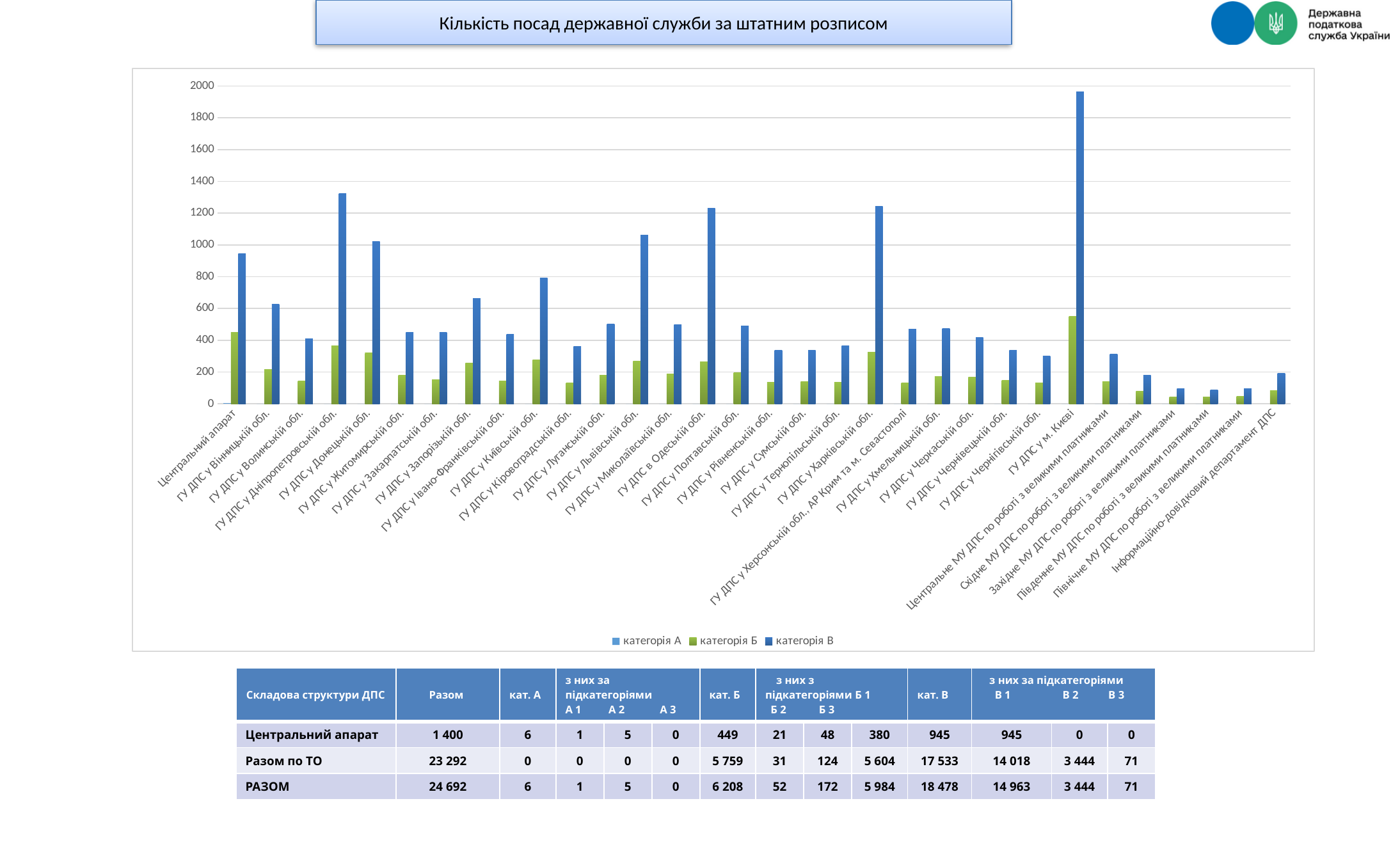
Which category has the highest value for категорія В? ГУ ДПС у м. Києві Is the value of категорія В for ГУ ДПС у Вінницькій обл. greater or less than 600? greater Is the value of категорія В for ГУ ДПС у Донецькій обл. greater or less than 1000? greater How many categories are shown along the x axis of the chart? 32 Which is larger for категорія В: ГУ ДПС у Дніпропетровській обл. or ГУ ДПС у Донецькій обл.? ГУ ДПС у Дніпропетровській обл. What kind of chart is shown on the slide? bar chart How many series does the chart legend list? 3 Which category has the highest value for категорія Б? ГУ ДПС у м. Києві Which is larger for категорія Б: Центральний апарат or ГУ ДПС у Волинській обл.? Центральний апарат What is the title of the chart on the slide? Кількість посад державної служби за штатним розписом Is the value of категорія В for ГУ ДПС у м. Києві greater or less than 1800? greater